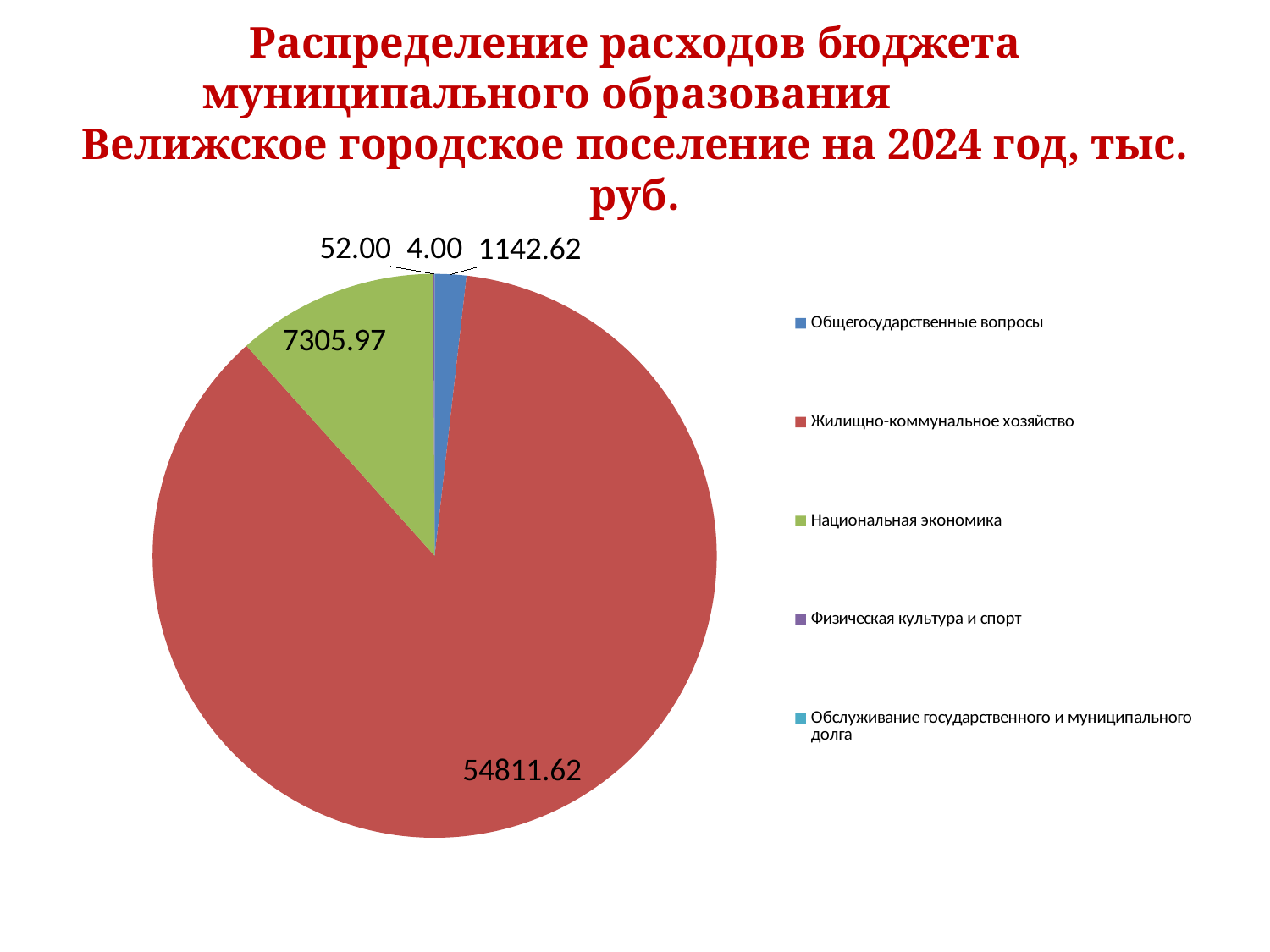
Which category has the largest slice of the pie? Жилищно-коммунальное хозяйство What is the value for Общегосударственные вопросы? 1142.62 What colour is the slice for Национальная экономика? Green What is the total of all the values shown on the pie chart? 63316.21 What is the value for Жилищно-коммунальное хозяйство? 54811.62 What is the value for Национальная экономика? 7305.97 Which is larger, Национальная экономика or Общегосударственные вопросы? Национальная экономика What type of chart is shown on the slide? Pie chart What is the difference between Жилищно-коммунальное хозяйство and Национальная экономика? 47505.65 How many categories does the legend list? 5 What share of the total does Жилищно-коммунальное хозяйство represent? 86.57% What is the difference between Национальная экономика and Общегосударственные вопросы? 6163.35